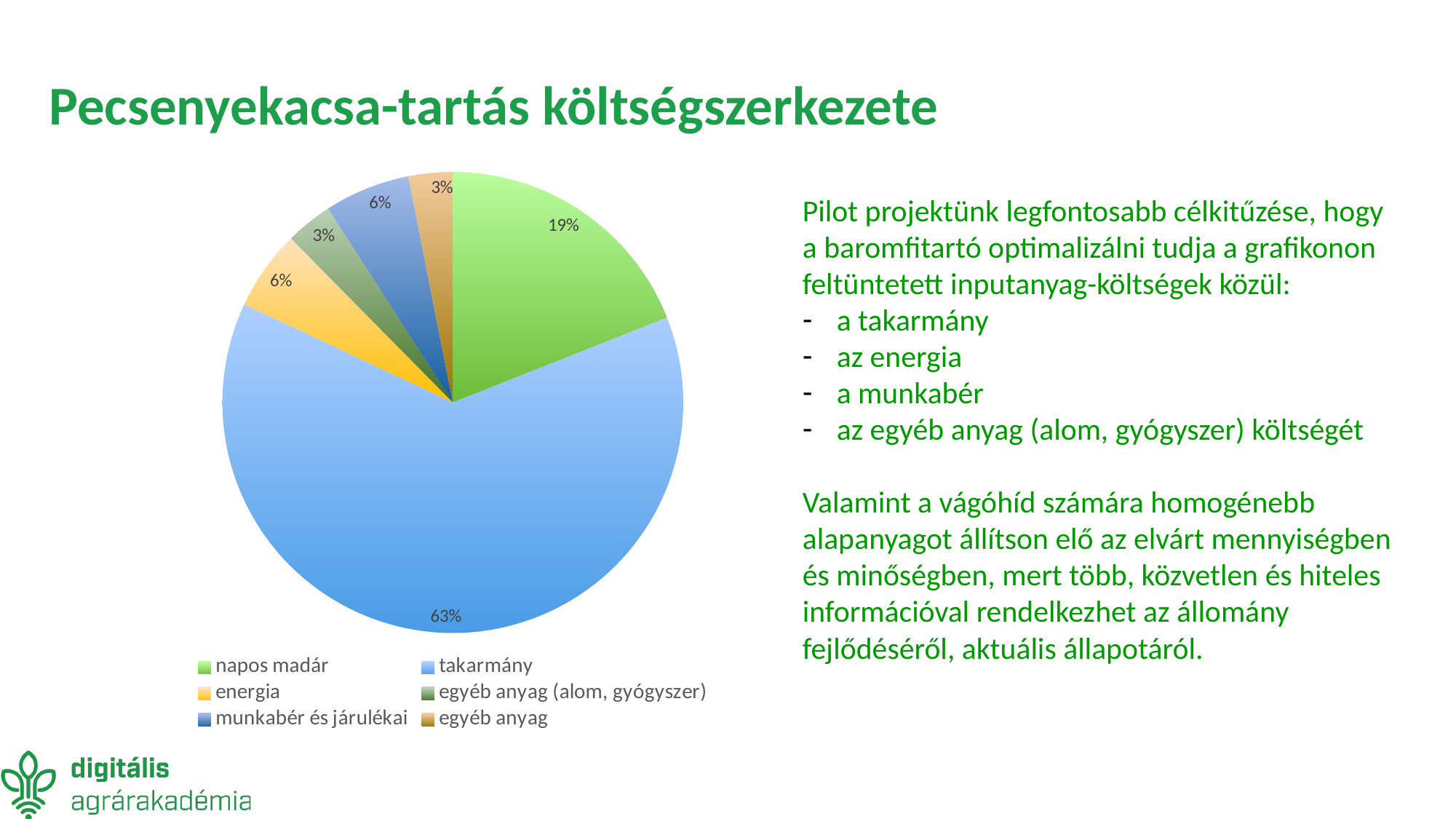
What percentage is shown for energia? 6% Which is larger, the slice for napos madár or the slice for energia? napos madár What is the difference in percentage points between takarmány and napos madár? 44 What percentage is shown for egyéb anyag (alom, gyógyszer)? 3% What share of the pie does takarmány represent? 63% What percentage is shown for munkabér és járulékai? 6% What percentage is shown for napos madár? 19% What type of chart is shown on the slide? pie chart How many entries does the legend list? 6 What colour is the takarmány slice? blue How many slices does the pie chart have? 6 Which category has the largest slice of the pie? takarmány